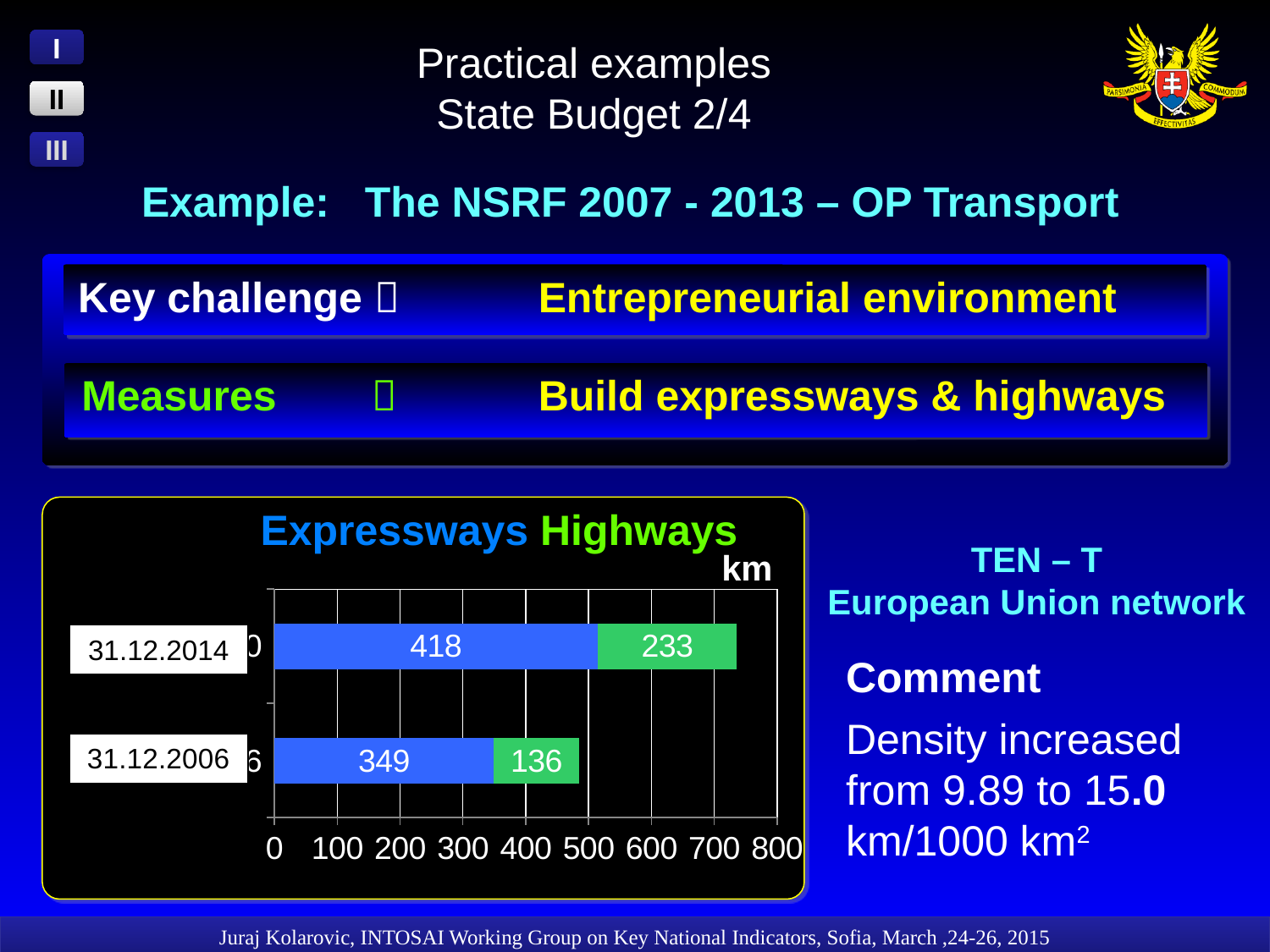
What is the total length (Expressways plus Highways) for 31.12.2014? 651 Which date has the larger Highways value, 31.12.2014 or 31.12.2006? 31.12.2014 By how much did the Highways value increase from 31.12.2006 to 31.12.2014? 97 What is the Highways value for 31.12.2014? 233 What is the total length (Expressways plus Highways) for 31.12.2006? 485 What is the Expressways value for 31.12.2006? 349 What is the Highways value for 31.12.2006? 136 How many series does the chart show? 2 By how much did the Expressways value increase from 31.12.2006 to 31.12.2014? 69 What kind of chart is shown on the slide? Stacked bar chart What unit is shown on the chart's axis? km What is the Expressways value for 31.12.2014? 418